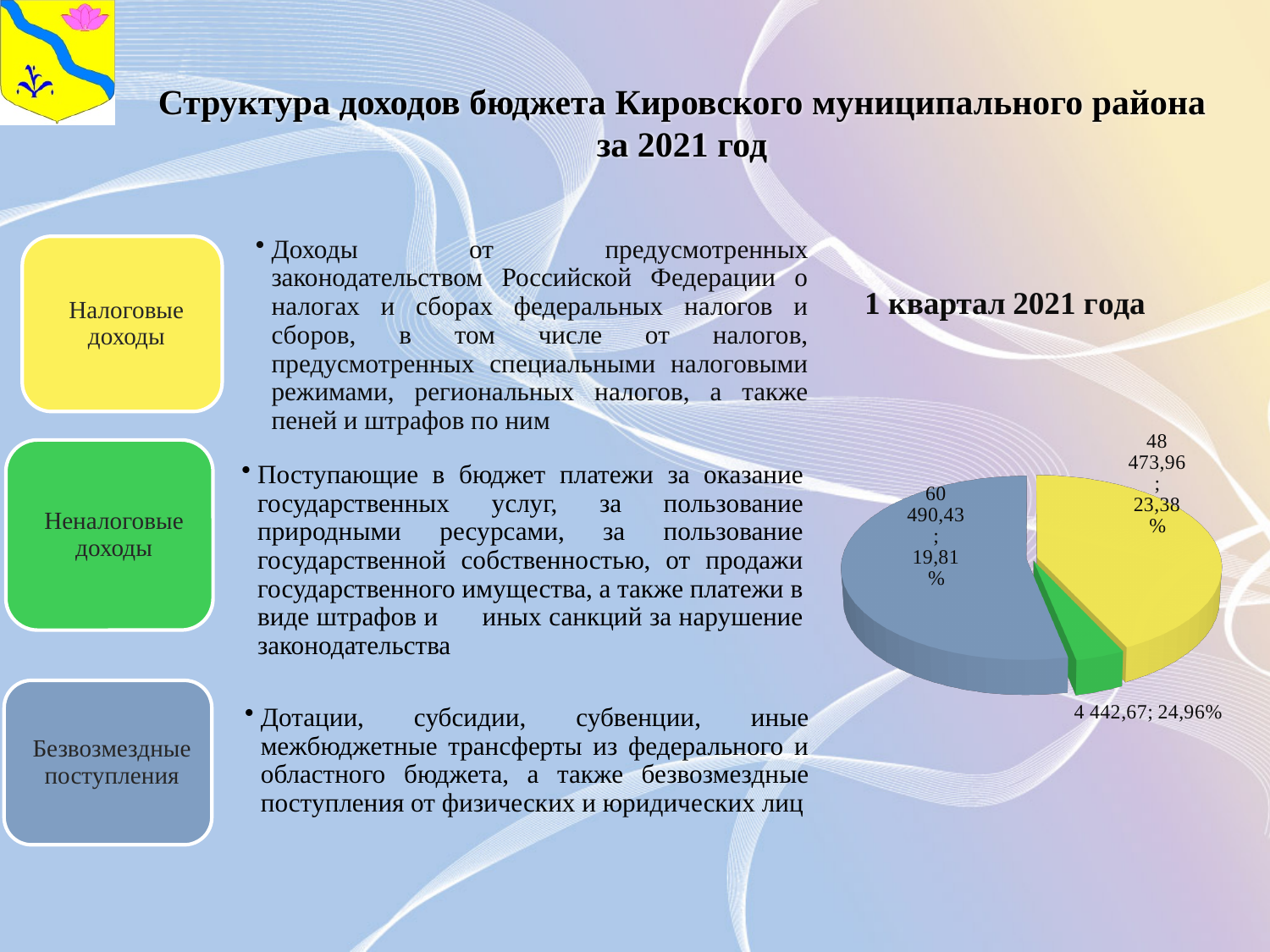
What is the title of the pie chart? 1 квартал 2021 года What percentage is printed on the blue-grey slice of the pie chart? 19,81% What is the difference between the values printed on the blue-grey slice and the yellow slice of the pie chart? 12 016,47 What kind of chart is shown on the slide? Pie chart What value is printed on the blue-grey slice of the pie chart? 60 490,43 What percentage is printed on the yellow slice of the pie chart? 23,38% How many slices does the pie chart have? 3 What value is printed on the yellow slice of the pie chart? 48 473,96 What percentage is printed on the green slice of the pie chart? 24,96% Which slice of the pie chart has the largest printed value? The blue-grey slice (60 490,43) What value is printed on the green slice of the pie chart? 4 442,67 Which slice of the pie chart has the smallest printed value? The green slice (4 442,67)